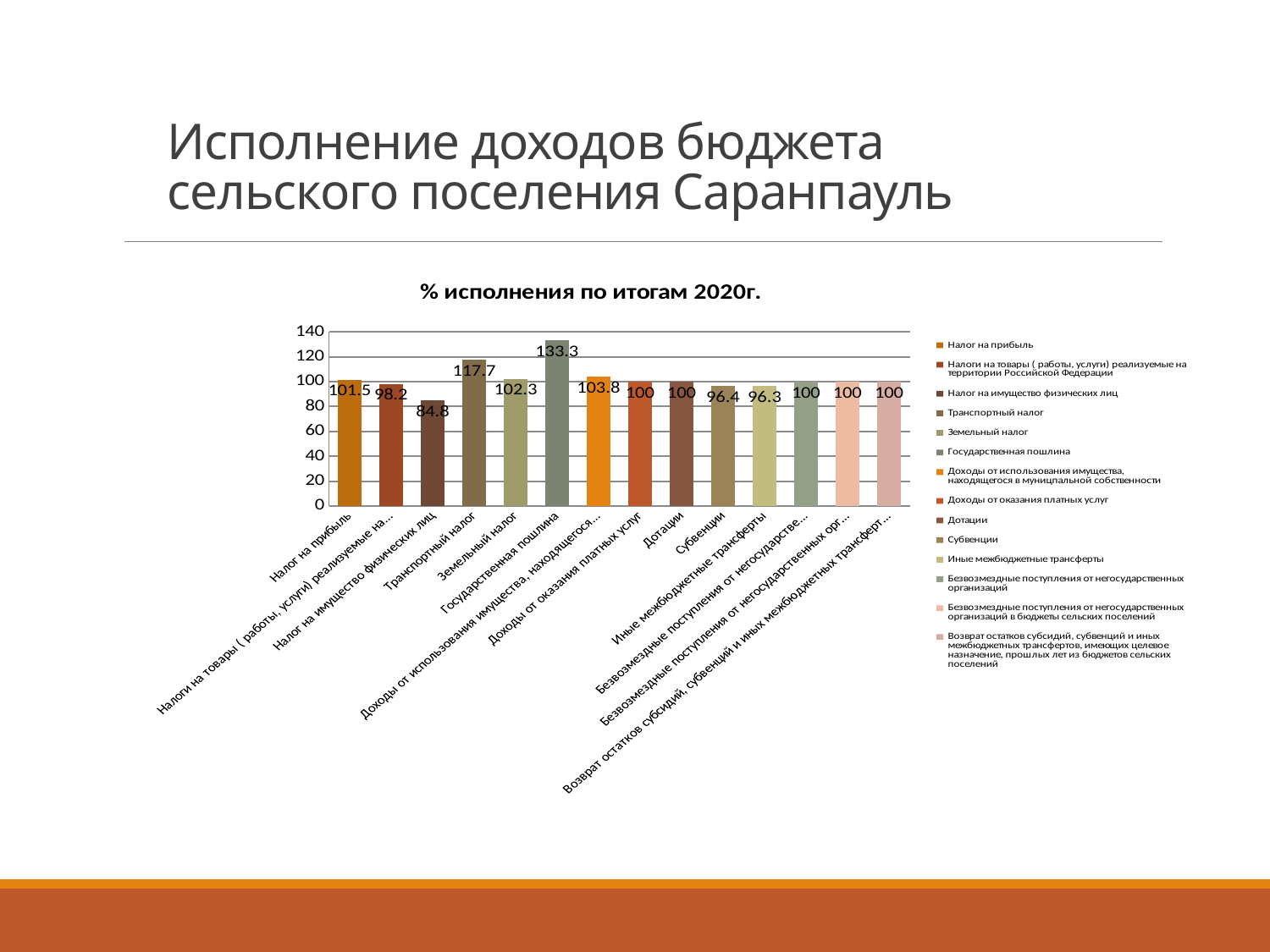
How many entries does the legend list? 14 What is the value for Транспортный налог? 117.7 What type of chart is shown on the slide? bar chart Which category has the highest value? Государственная пошлина Which is larger, the value for Земельный налог or the value for Доходы от использования имущества? Доходы от использования имущества What is the difference between the values for Государственная пошлина and Транспортный налог? 15.6 What is the value for Налог на прибыль? 101.5 How many bars are plotted in the chart? 14 What is the value for Субвенции? 96.4 What is the value for Налог на имущество физических лиц? 84.8 Which category has the lowest value? Налог на имущество физических лиц What is the chart's title? % исполнения по итогам 2020г.